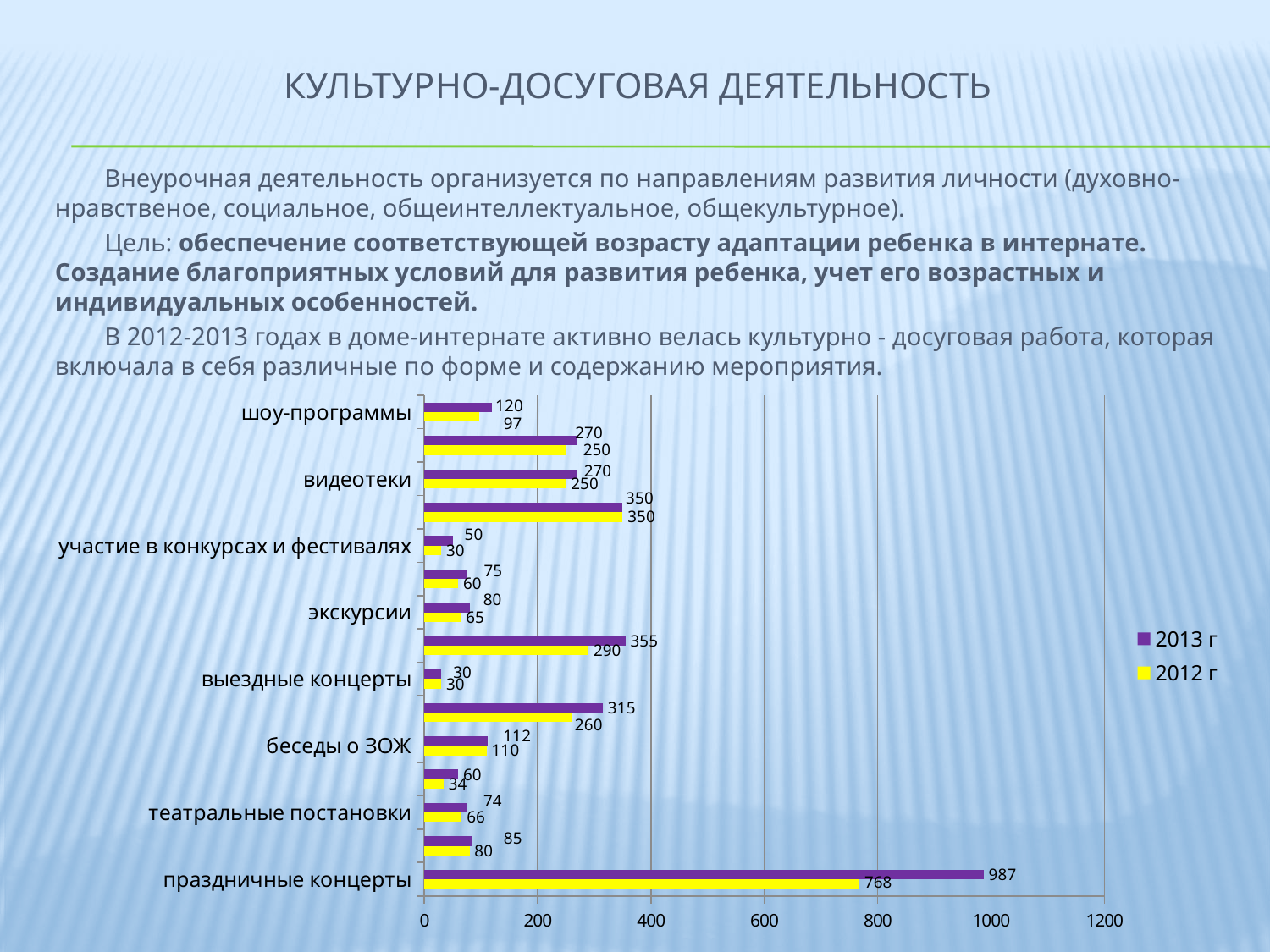
What is the difference between the 2013 г and 2012 г values for праздничные концерты? 219 Which labeled category has the lowest value in the 2013 г series? выездные концерты What is the value for участие в конкурсах и фестивалях in the 2012 г series? 30 What is the value for праздничные концерты in the 2013 г series? 987 What is the value for шоу-программы in the 2013 г series? 120 What is the difference between the 2013 г and 2012 г values for видеотеки? 20 What is the value for беседы о ЗОЖ in the 2012 г series? 110 What kind of chart is shown on the slide? bar chart Which category has the highest value in the 2013 г series? праздничные концерты What is the value for праздничные концерты in the 2012 г series? 768 How many series does the legend list? 2 For экскурсии, which series has the larger value, 2013 г or 2012 г? 2013 г